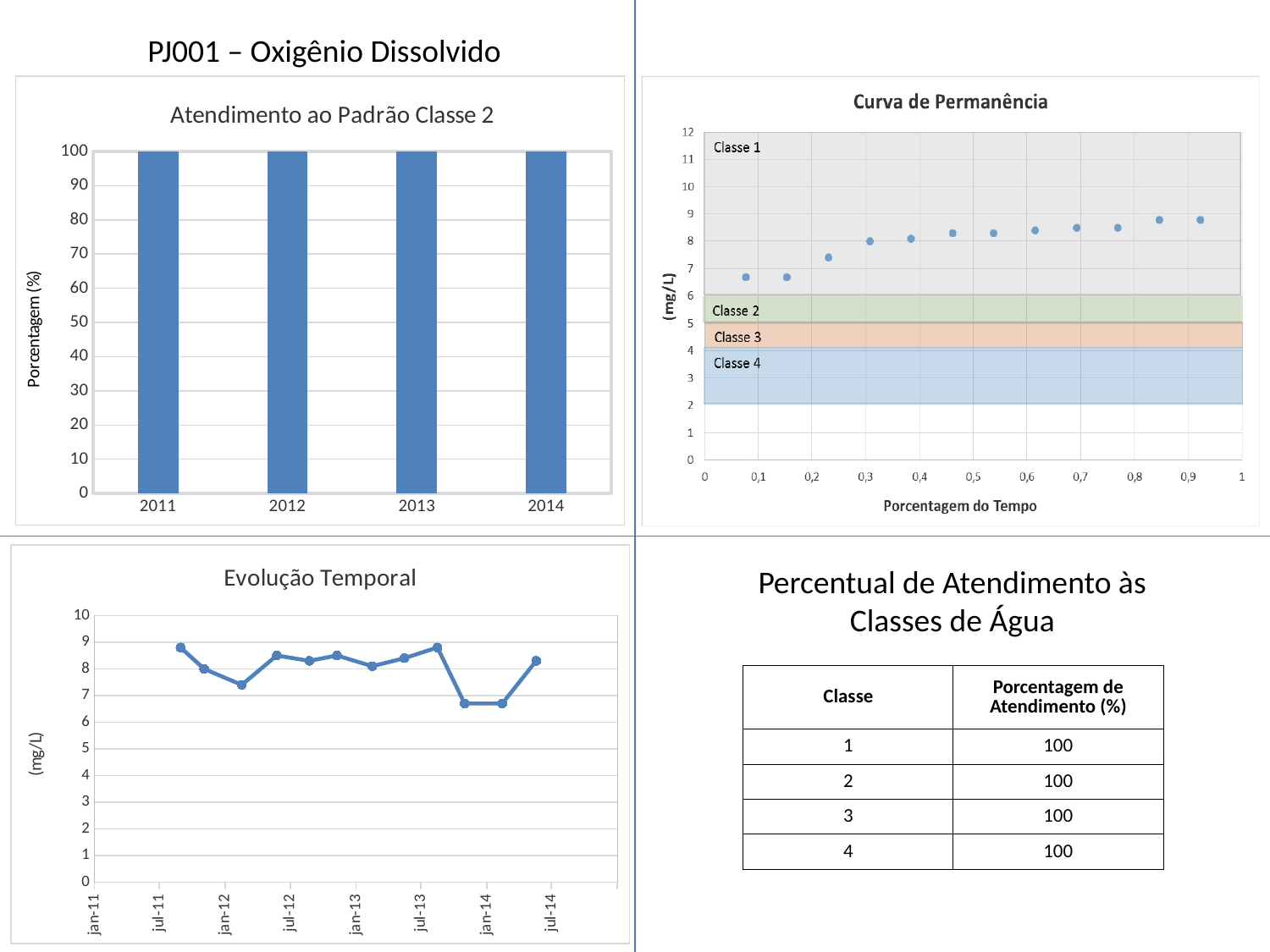
In the 'Atendimento ao Padrão Classe 2' chart, what is the value for 2011? 100 How many data points are plotted in the 'Curva de Permanência' chart? 12 In the 'Evolução Temporal' chart, is the value at jan-14 greater or less than 7? less How many years are shown in the 'Atendimento ao Padrão Classe 2' chart? 4 In the 'Curva de Permanência' chart, do the plotted values rise or fall as Porcentagem do Tempo increases? rise In the 'Curva de Permanência' chart, is the value of the last point (near 0,9) greater or less than 8? greater In the 'Atendimento ao Padrão Classe 2' chart, what is the value for 2014? 100 What kind of chart is 'Evolução Temporal'? line chart What kind of chart is 'Atendimento ao Padrão Classe 2'? bar chart What is the y-axis label of the 'Atendimento ao Padrão Classe 2' chart? Porcentagem (%) In the 'Curva de Permanência' chart, which class band is labelled at the top of the plot area? Classe 1 In the 'Curva de Permanência' chart, is the value of the first point (near 0,1) greater or less than 7? less